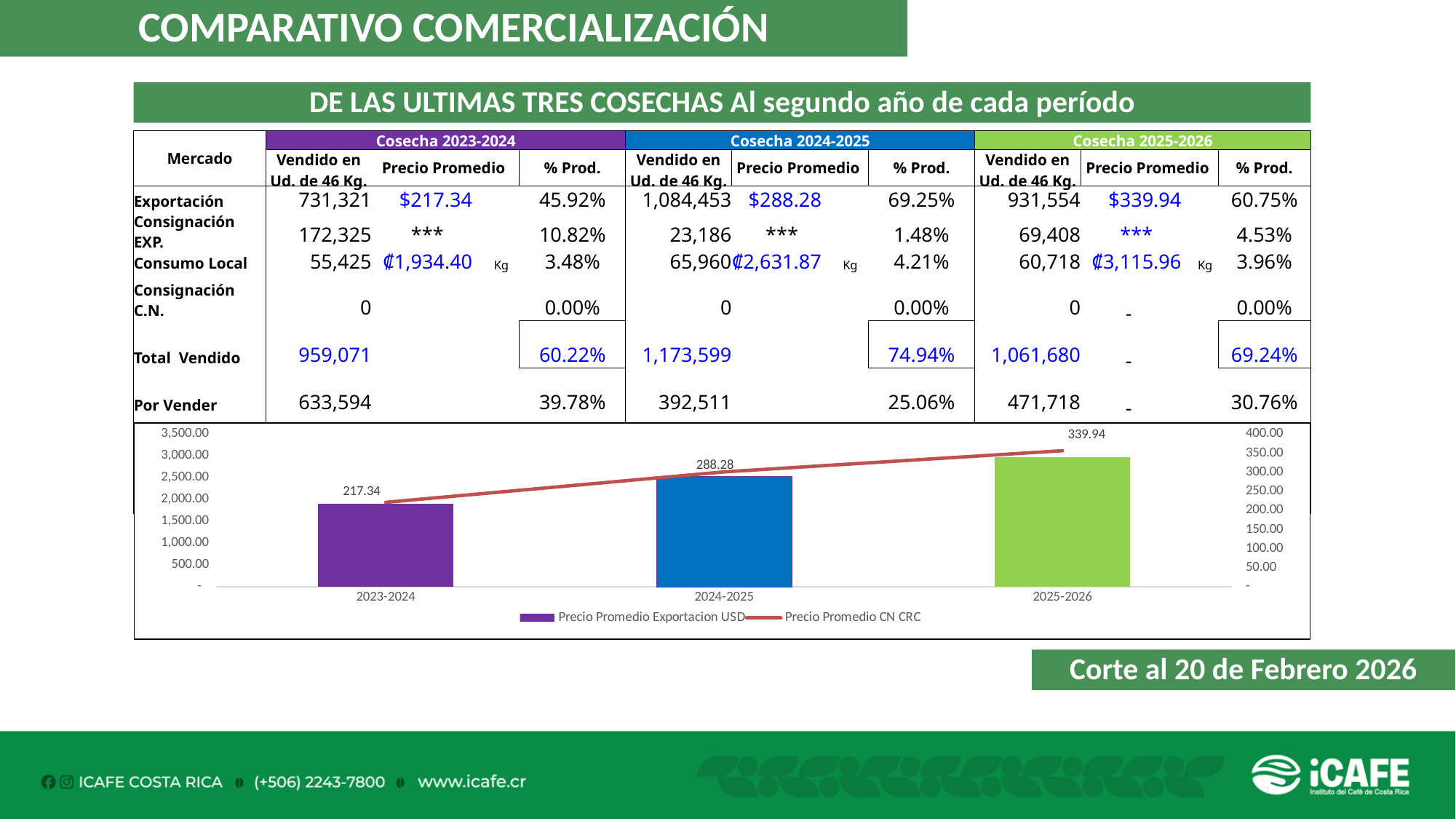
How many periods are shown on the x axis of the chart? 3 Do the Precio Promedio Exportacion USD bars rise or fall from 2023-2024 to 2025-2026? rise Which period has the lowest Precio Promedio Exportacion USD bar? 2023-2024 What is the difference between the Precio Promedio Exportacion USD values for 2025-2026 and 2023-2024? 122.60 How many series does the chart legend list? 2 Which period has the highest Precio Promedio Exportacion USD bar? 2025-2026 Is the Precio Promedio CN CRC line value for 2023-2024 greater or less than 1,500.00 on the left axis? greater What is the Precio Promedio Exportacion USD value for 2024-2025? 288.28 What is the Precio Promedio Exportacion USD value for 2025-2026? 339.94 What kind of chart is shown on the slide? bar chart with a line What is the Precio Promedio Exportacion USD value for 2023-2024? 217.34 Which is larger, the Precio Promedio Exportacion USD bar for 2024-2025 or for 2023-2024? 2024-2025